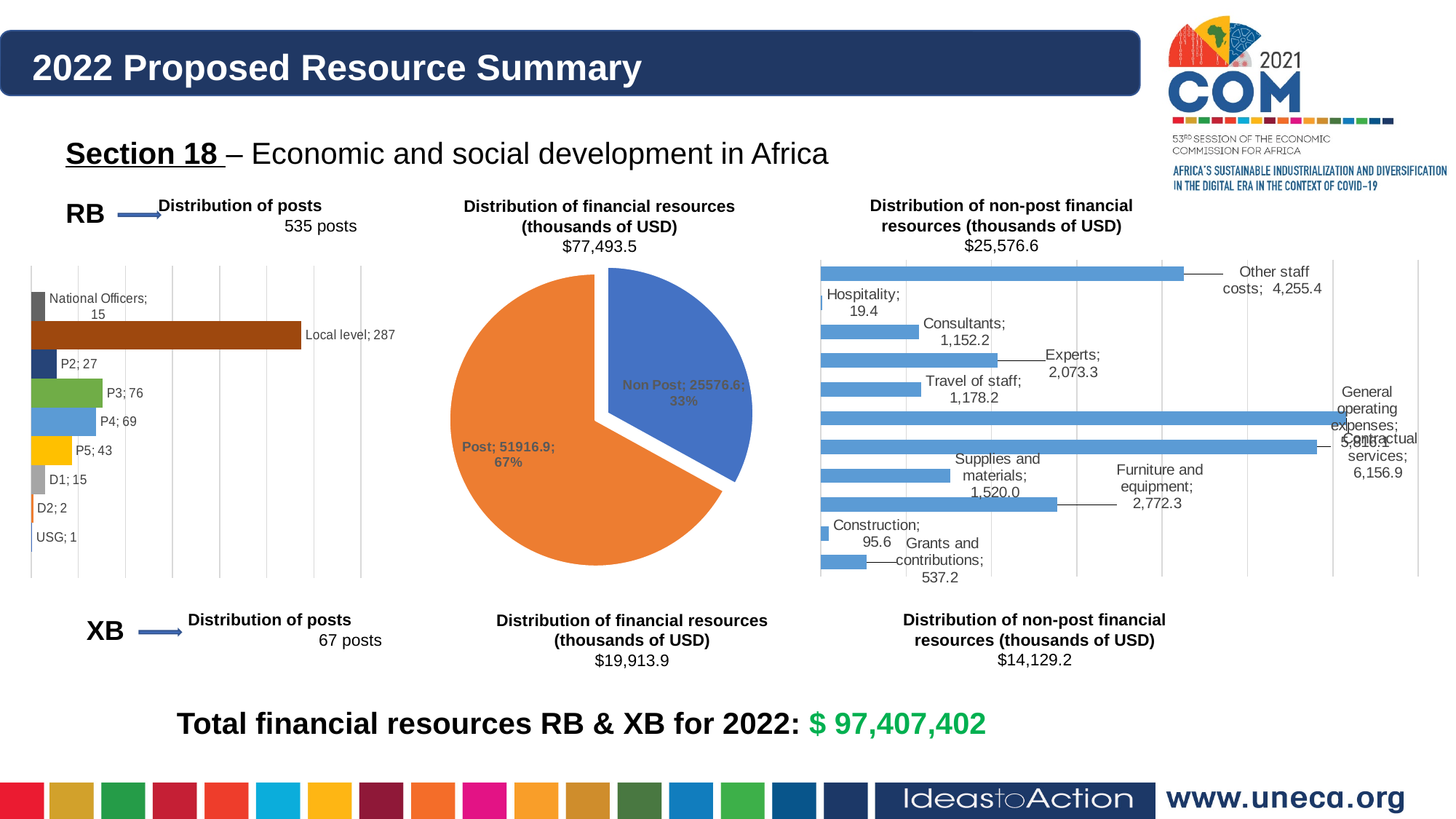
In the Distribution of non-post financial resources chart, what is the value for Furniture and equipment? 2,772.3 In the Distribution of posts chart, which category has the most posts? Local level In the Distribution of financial resources pie chart, what share is Non Post? 33% What kind of chart is the Distribution of financial resources chart? Pie chart In the Distribution of posts chart, what is the difference between the number of P4 posts and P5 posts? 26 In the Distribution of non-post financial resources chart, which is larger: Experts or Consultants? Experts In the Distribution of financial resources pie chart, what is the value for Post? 51916.9 In the Distribution of posts chart, how many categories are shown? 9 In the Distribution of non-post financial resources chart, which category has the lowest value? Hospitality In the Distribution of posts chart, how many P3 posts are there? 76 In the Distribution of posts chart, how many posts are at the Local level? 287 In the Distribution of posts chart, which category has the fewest posts? USG